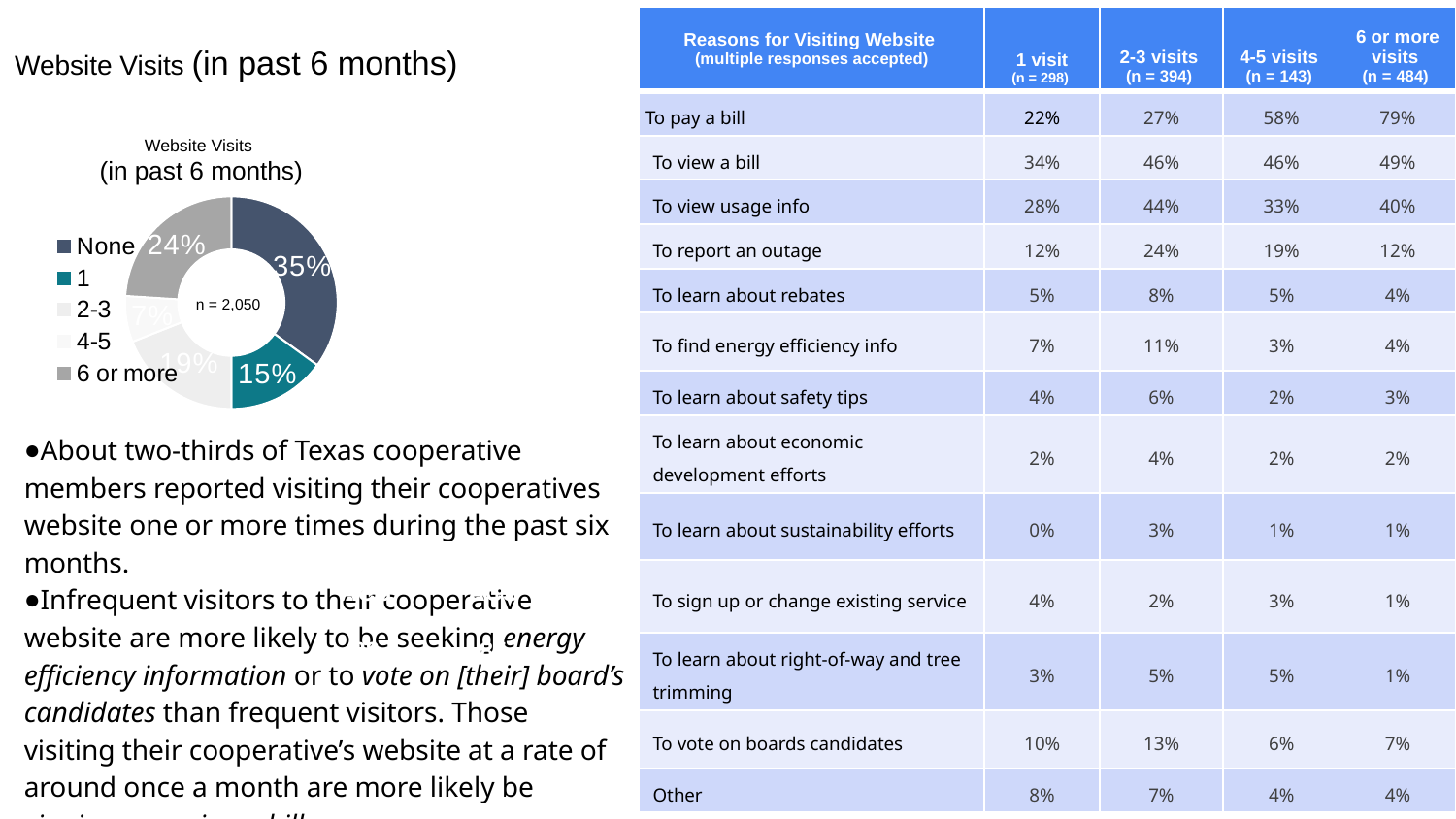
Which category has the smallest slice in the Website Visits chart? 4-5 What kind of chart is the Website Visits chart? doughnut chart In the Website Visits chart, which is larger: the share for 1 visit or the share for 2-3 visits? 2-3 What sample size (n) is shown in the center of the Website Visits chart? n = 2,050 In the Website Visits chart, what share of members reported no website visits (None)? 35% Which category has the largest slice in the Website Visits chart? None In the Website Visits chart, what percentage of members visited the website 1 time? 15% In the Website Visits chart, what percentage of members visited the website 4-5 times? 7% In the Website Visits chart, what percentage of members visited the website 2-3 times? 19% In the Website Visits chart, what is the difference in percentage points between the None slice and the 6 or more slice? 11 How many categories does the legend of the Website Visits chart list? 5 In the Website Visits chart, what percentage of members visited the website 6 or more times? 24%